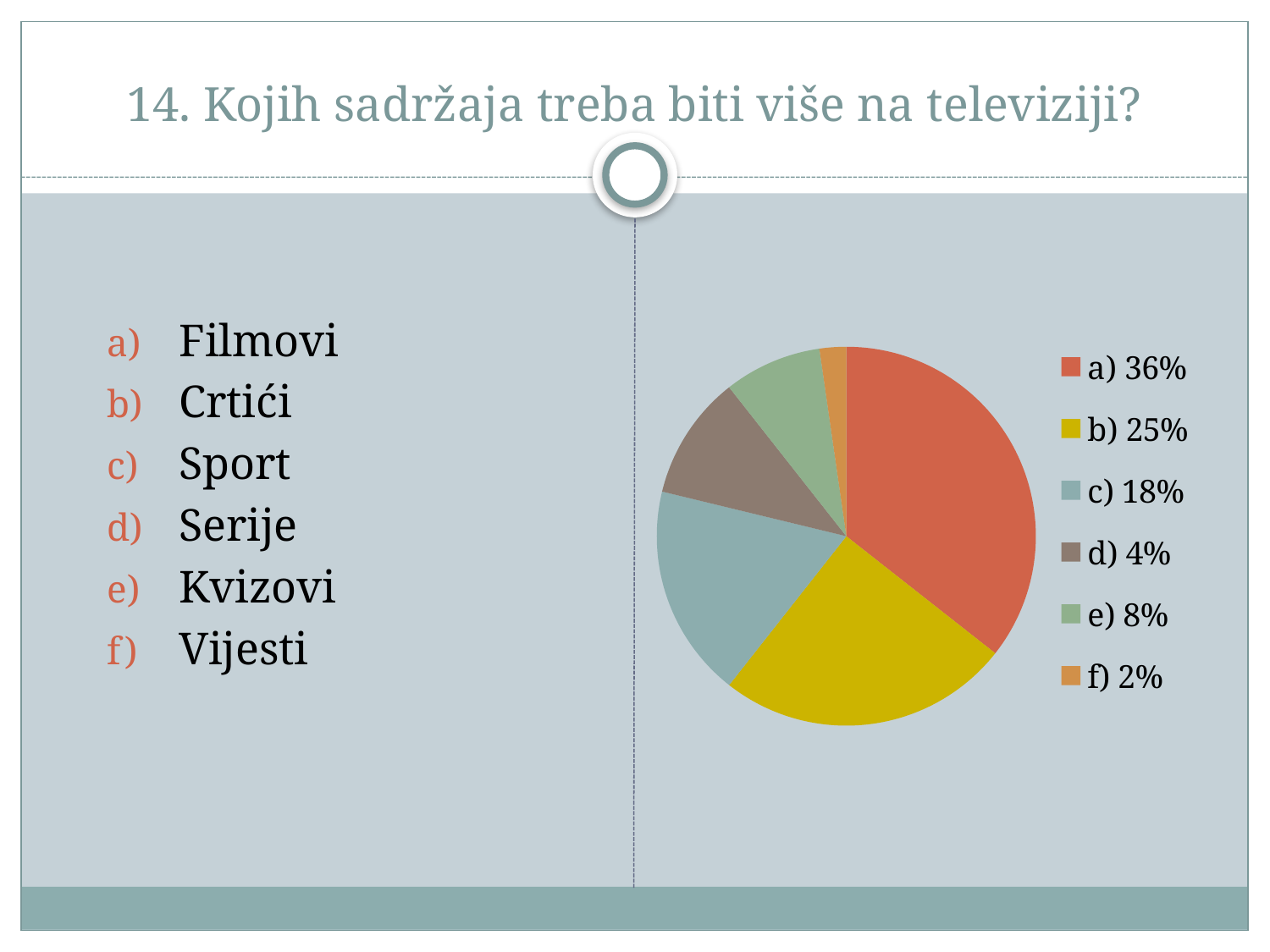
What percentage does the legend show for option c)? 18% How many slices does the pie chart have? 6 Which is larger, the slice for option b) or the slice for option c)? b) Which option has the smallest slice of the pie? f) 2% What is the difference in percentage points between option c) and option d)? 14 What percentage does the legend show for option e)? 8% What is the difference in percentage points between option a) and option b)? 11 Which option has the largest slice of the pie? a) 36% What colour is the slice for option b) 25%? yellow What kind of chart is shown on the slide? pie chart How many entries does the legend list? 6 What percentage does the legend show for option a)? 36%